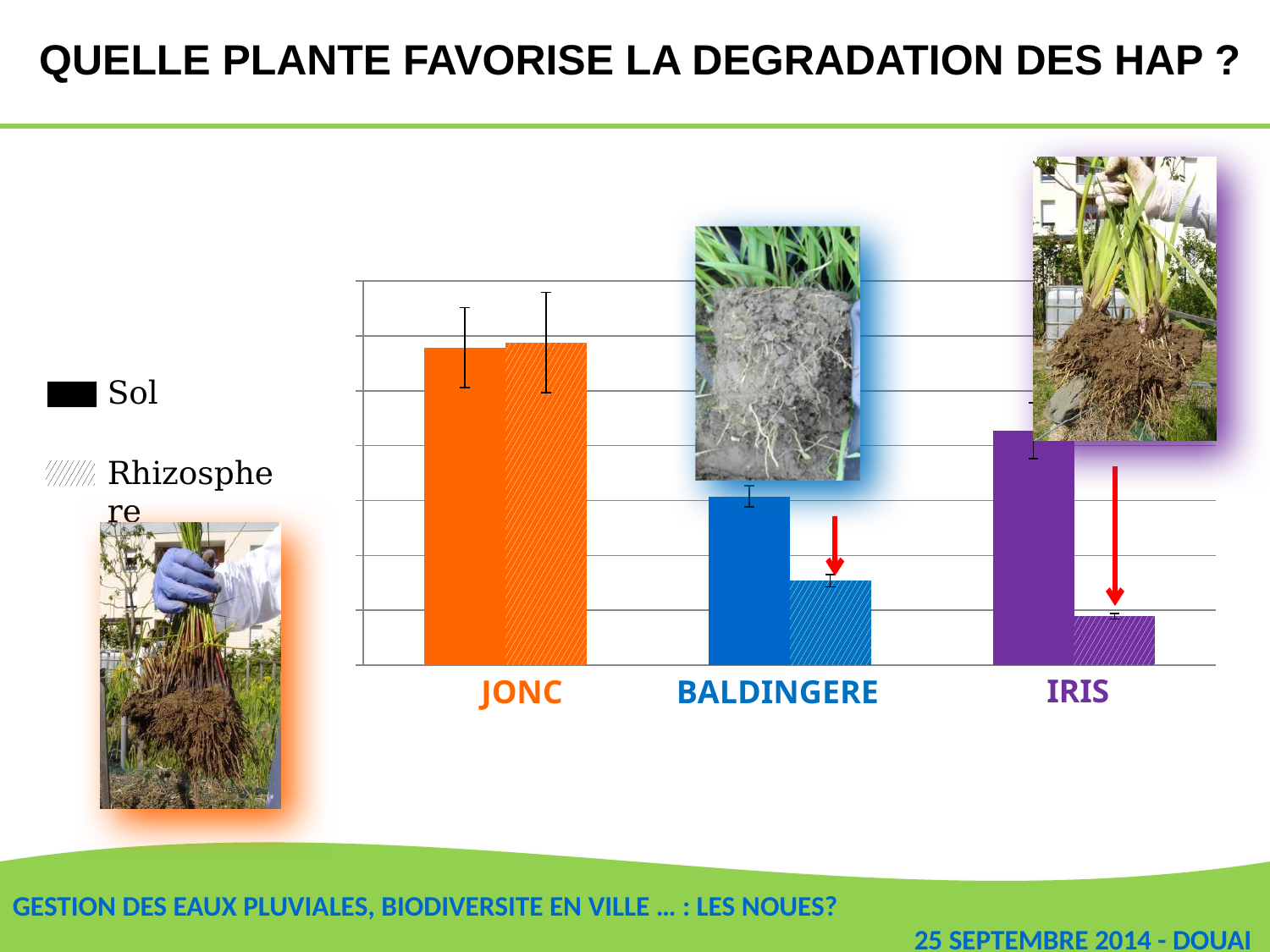
Which plant's bars are drawn in purple in the chart? IRIS How many series does the chart's legend list? 2 What are the two series named in the chart's legend? Sol and Rhizosphere Which plant has the lowest Rhizosphere value in the chart? IRIS For IRIS, which is larger: the Sol value or the Rhizosphere value? Sol Which plant has the lowest Sol value in the chart? BALDINGERE How many plant categories are shown on the x axis of the chart? 3 For BALDINGERE, which is larger: the Sol value or the Rhizosphere value? Sol Which plant has the highest Sol value in the chart? JONC Which plant has the highest Rhizosphere value in the chart? JONC What kind of chart is shown on the slide? bar chart Which is larger: the Sol value for IRIS or the Sol value for BALDINGERE? IRIS